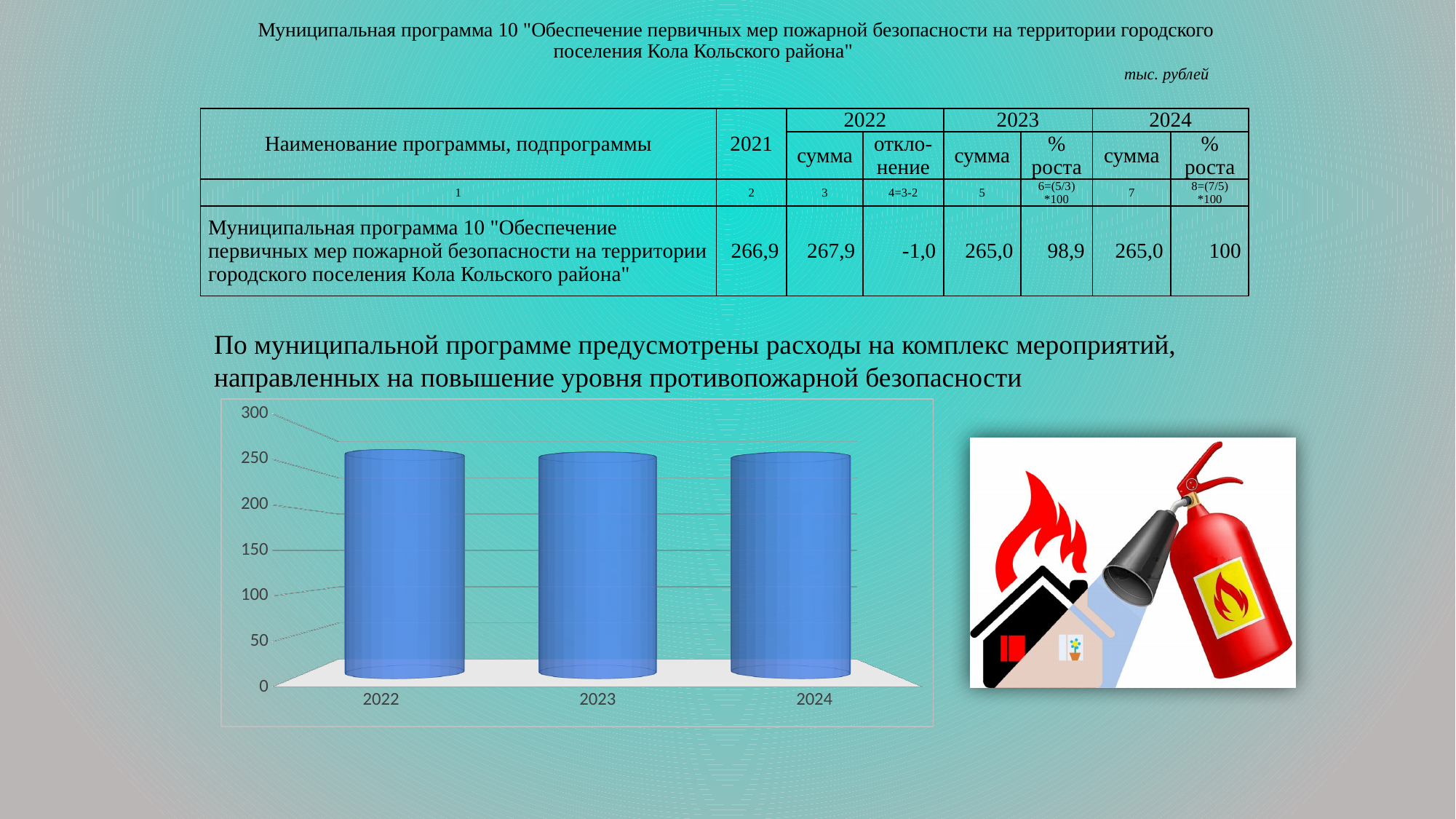
Is the value for 2024 in the chart greater or less than 150? greater Is the value for 2023 in the chart greater or less than 100? greater Is the value for 2022 in the chart greater or less than 200? greater What kind of chart is shown on the slide? bar chart What is the first category label on the x axis of the chart? 2022 How many categories are shown on the x axis of the chart? 3 What is the highest tick value shown on the vertical axis of the chart? 300